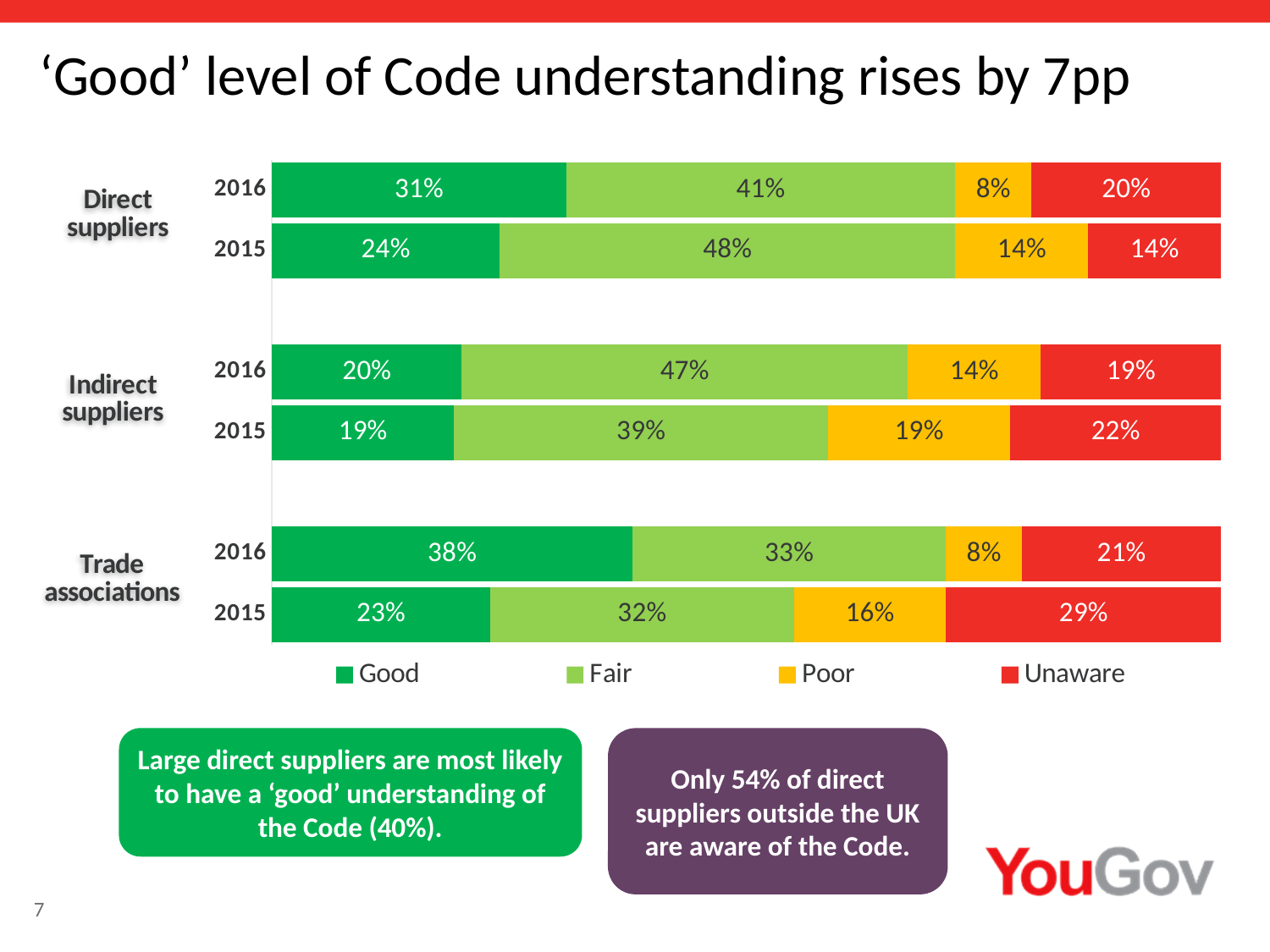
Which group and year has the highest 'Good' value? Trade associations 2016 How many series does the legend list? 4 What is the 'Fair' value for indirect suppliers in 2016? 47% Which colour represents the 'Unaware' series in the legend? Red What is the 'Unaware' value for trade associations in 2015? 29% How many bars are plotted in the chart? 6 By how many percentage points did the 'Good' value for direct suppliers change from 2015 to 2016? 7 percentage points What is the total of the 'Good' and 'Fair' segments for trade associations in 2016? 71% What type of chart is shown on the slide? Stacked bar chart What percentage of direct suppliers had a 'Good' understanding of the Code in 2016? 31% Which is larger: the 'Poor' value for indirect suppliers in 2015 or in 2016? 2015 Which group and year has the lowest 'Good' value? Indirect suppliers 2015